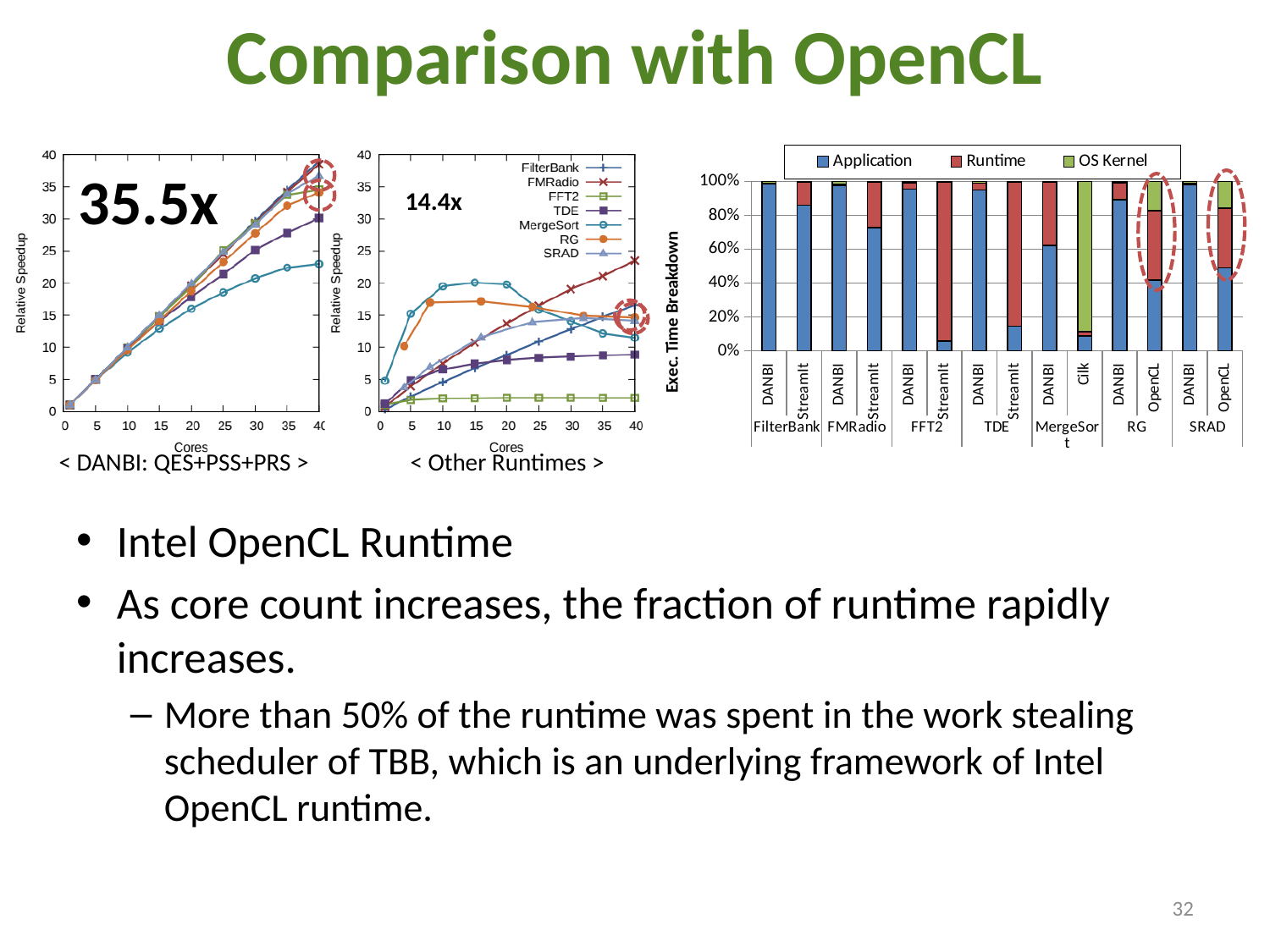
What kind of chart is the right-hand 'Exec. Time Breakdown' chart? Stacked bar chart What kind of chart is the left chart '< DANBI: QES+PSS+PRS >'? Line chart What is the maximum speedup annotated on the left chart titled '< DANBI: QES+PSS+PRS >'? 35.5x How many series does the legend of the right-hand 'Exec. Time Breakdown' chart list? 3 How many series does the legend of the middle chart '< Other Runtimes >' list? 7 What is the label of the x axis on the left chart '< DANBI: QES+PSS+PRS >'? Cores In the right-hand 'Exec. Time Breakdown' chart, is the Application share for the FFT2 StreamIt bar greater or less than 20%? less In the middle chart '< Other Runtimes >', does the FMRadio speedup rise or fall as the number of cores increases? Rises How many benchmark groups are shown along the x axis of the right-hand 'Exec. Time Breakdown' chart? 7 In the right-hand 'Exec. Time Breakdown' chart, is the Application share for the RG OpenCL bar greater or less than 60%? less What is the maximum speedup annotated on the middle chart titled '< Other Runtimes >'? 14.4x In the middle chart '< Other Runtimes >', is the FFT2 speedup at 40 cores greater or less than 5? less